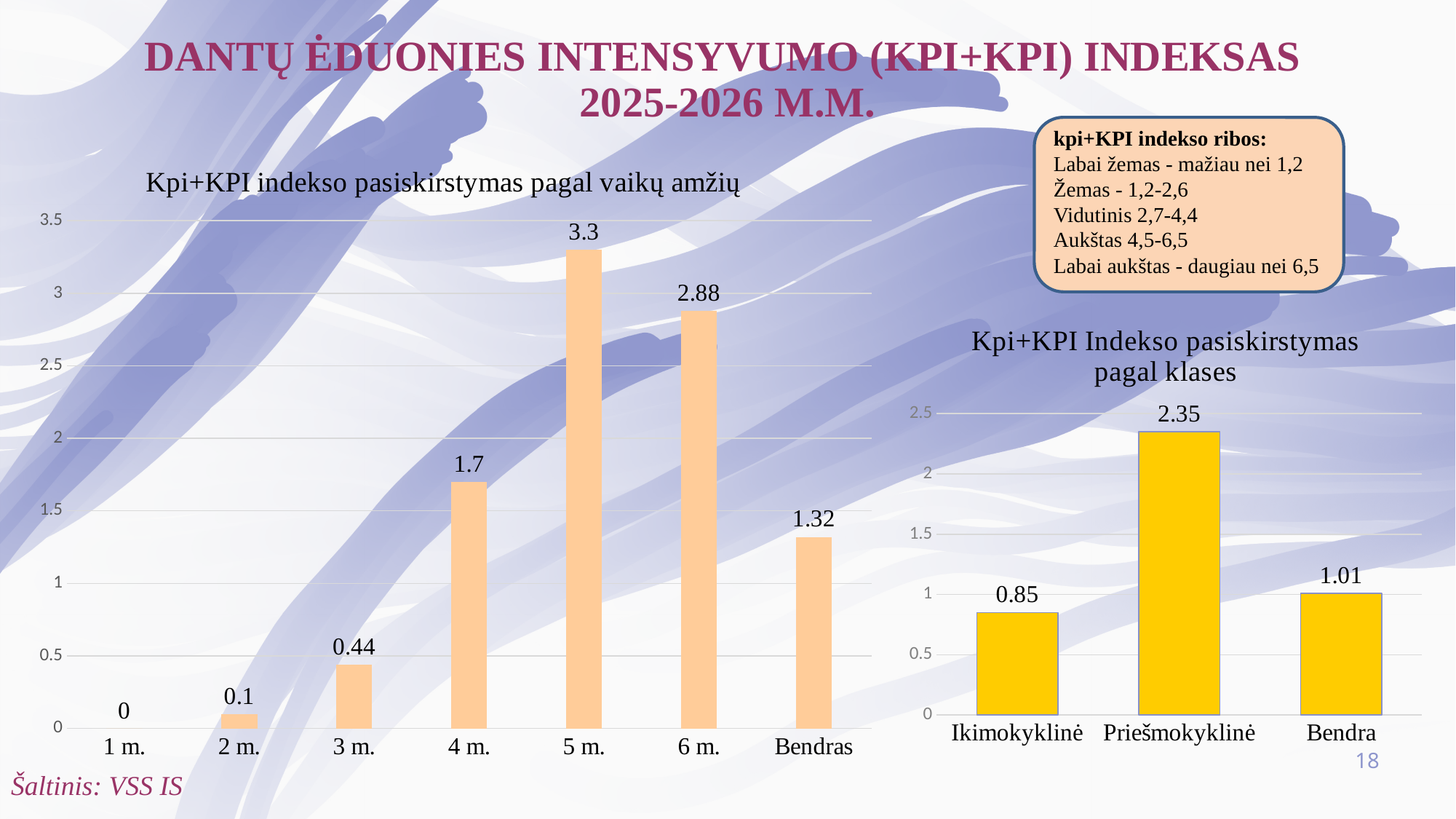
In the chart 'Kpi+KPI indekso pasiskirstymas pagal vaikų amžių', what is the value for 5 m.? 3.3 In the chart 'Kpi+KPI indekso pasiskirstymas pagal vaikų amžių', what is the difference between the values for 5 m. and 6 m.? 0.42 In the chart 'Kpi+KPI indekso pasiskirstymas pagal vaikų amžių', how many categories are shown on the x axis? 7 What type of chart is 'Kpi+KPI Indekso pasiskirstymas pagal klases'? Bar chart In the chart 'Kpi+KPI indekso pasiskirstymas pagal vaikų amžių', which category has the lowest value? 1 m. In the chart 'Kpi+KPI indekso pasiskirstymas pagal vaikų amžių', what is the value for 3 m.? 0.44 In the chart 'Kpi+KPI Indekso pasiskirstymas pagal klases', which category has the lowest value? Ikimokyklinė In the chart 'Kpi+KPI indekso pasiskirstymas pagal vaikų amžių', is the value for 4 m. greater or less than 1.5? greater In the chart 'Kpi+KPI Indekso pasiskirstymas pagal klases', what is the value for Priešmokyklinė? 2.35 In the chart 'Kpi+KPI Indekso pasiskirstymas pagal klases', which is larger, Bendra or Ikimokyklinė? Bendra In the chart 'Kpi+KPI Indekso pasiskirstymas pagal klases', what is the difference between Priešmokyklinė and Ikimokyklinė? 1.5 In the chart 'Kpi+KPI indekso pasiskirstymas pagal vaikų amžių', which age group has the highest value? 5 m.